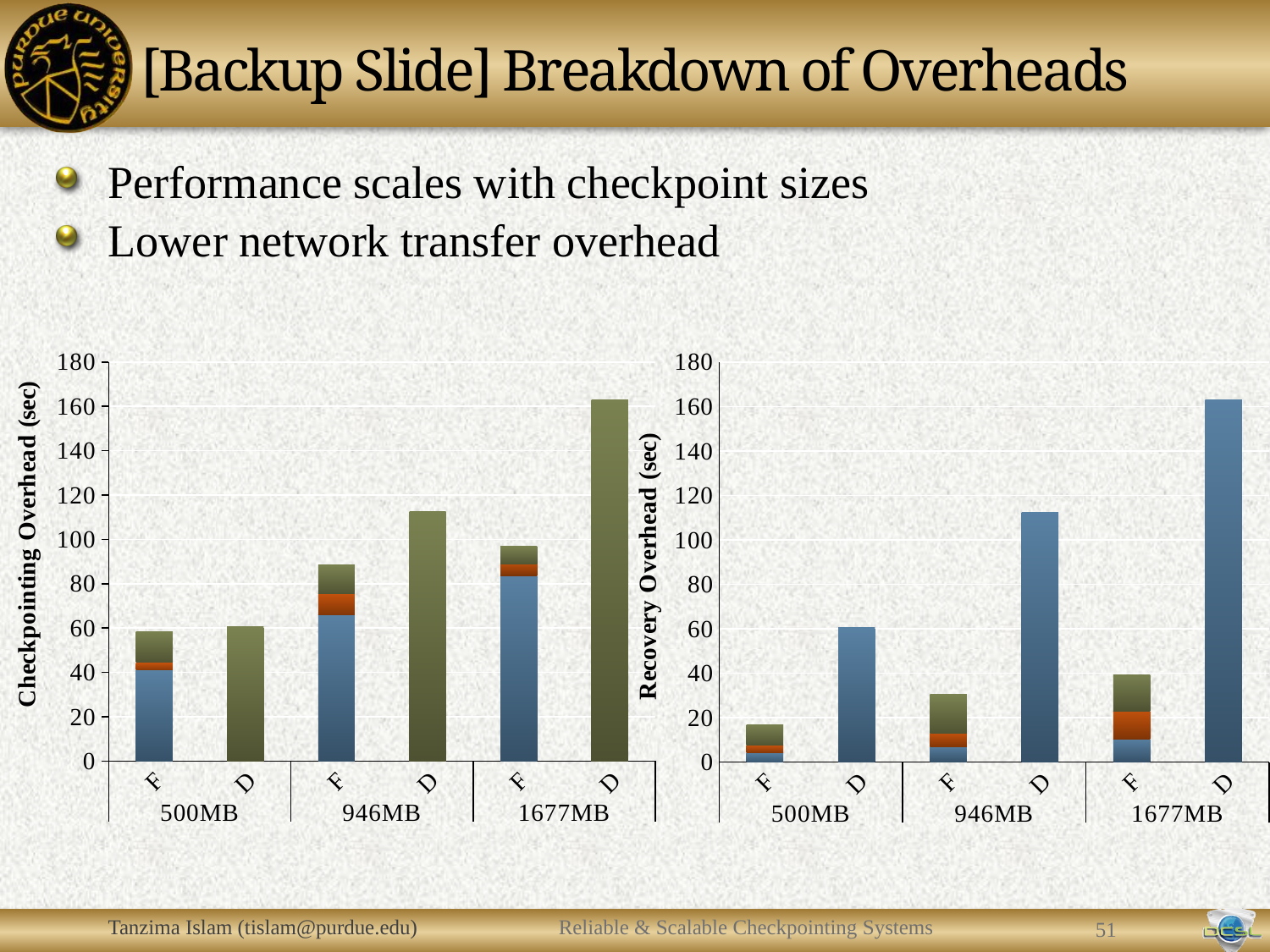
In the left chart (Checkpointing Overhead), is the value for D at 1677MB greater or less than 140? greater In the left chart (Checkpointing Overhead), which is larger at 946MB, F or D? D What kind of chart is the left chart (Checkpointing Overhead)? bar chart What is the y-axis title of the left chart? Checkpointing Overhead (sec) In the right chart (Recovery Overhead), is the value for D at 946MB greater or less than 100? greater In the left chart (Checkpointing Overhead), which bar is the highest? D at 1677MB In the right chart (Recovery Overhead), do the D bars rise or fall as the checkpoint size increases from 500MB to 1677MB? rise In the right chart (Recovery Overhead), which is larger at 500MB, F or D? D In the right chart (Recovery Overhead), which bar is the lowest? F at 500MB In the right chart (Recovery Overhead), is the value for F at 1677MB greater or less than 60? less How many bars are plotted in the right chart (Recovery Overhead)? 6